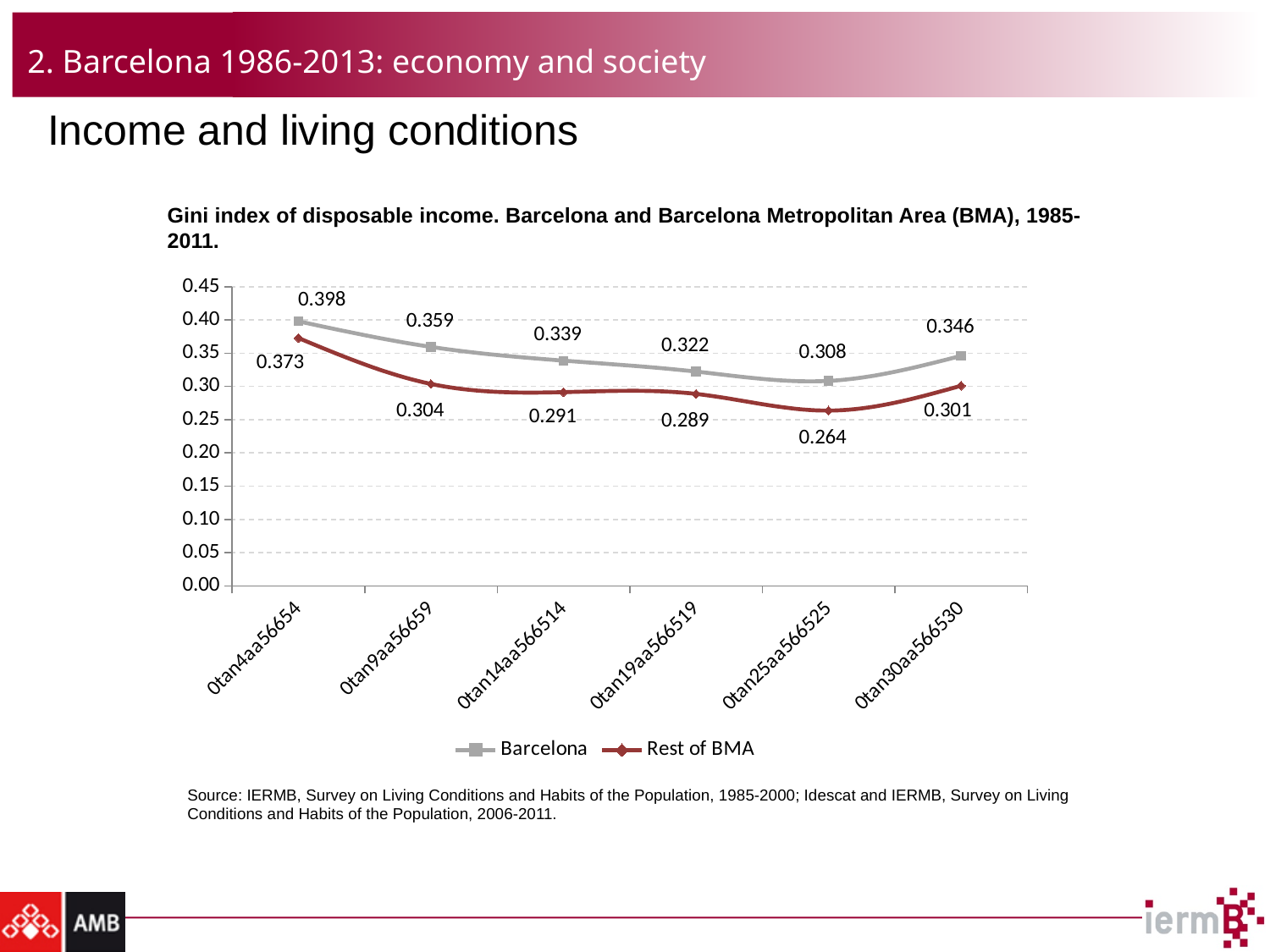
What is the highest value plotted for the Rest of BMA series? 0.373 What is the lowest value plotted for the Barcelona series? 0.308 What is the lowest value plotted for the Rest of BMA series? 0.264 What is the value of the first data point for Rest of BMA? 0.373 At the last data point, which series has the higher value, Barcelona or Rest of BMA? Barcelona How many series does the legend list? 2 Does the Barcelona series rise or fall from the first data point to the fifth data point? fall How many data points does each series have? 6 What is the value of the last data point for Rest of BMA? 0.301 What type of chart is shown on the slide? line chart What is the difference between the Barcelona and Rest of BMA values at the fifth data point? 0.044 What is the value of the first data point for Barcelona? 0.398